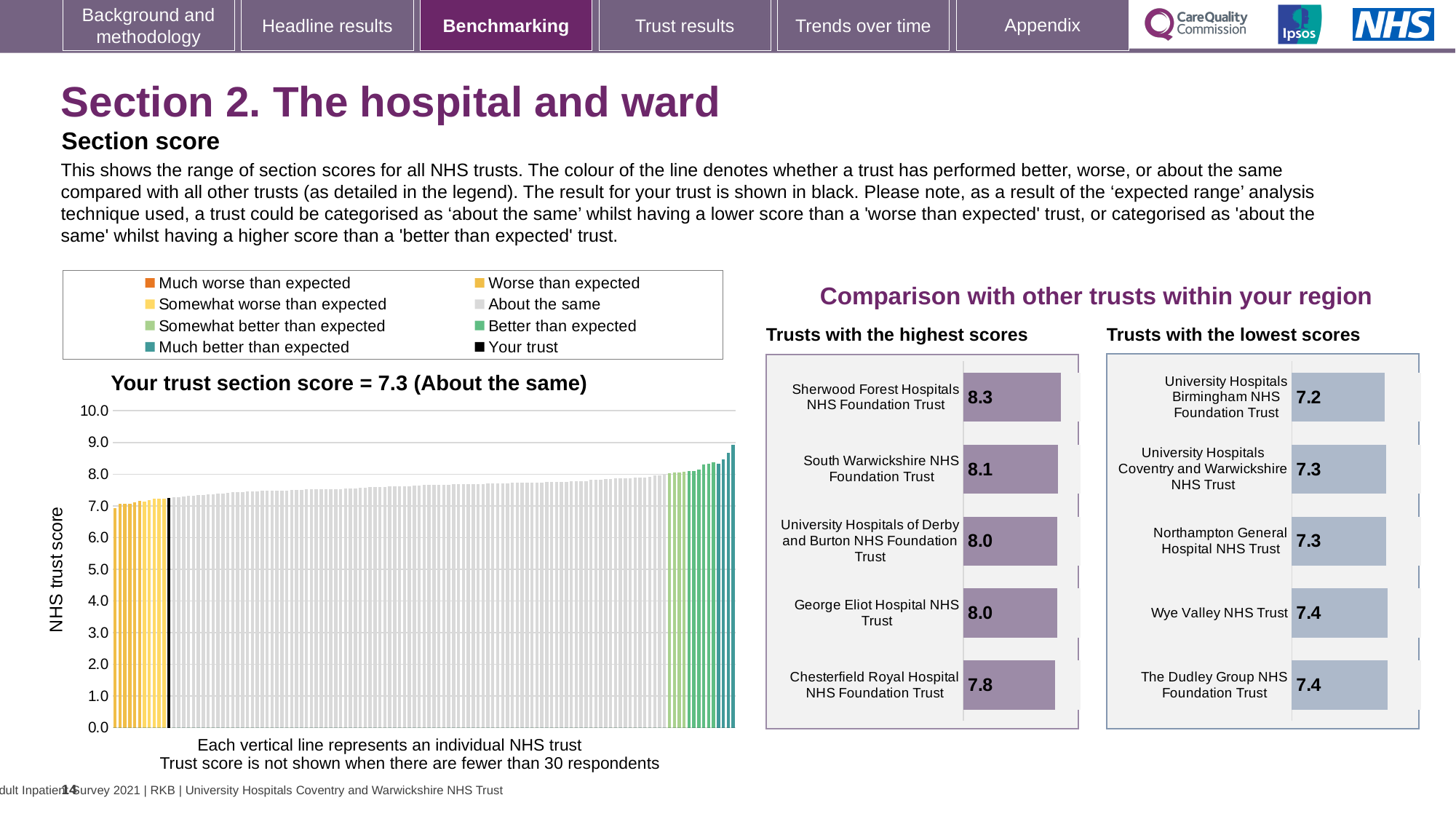
In the main chart on the left, do the trust scores rise or fall from left to right? rise In the 'Trusts with the highest scores' chart, what is the score for Chesterfield Royal Hospital NHS Foundation Trust? 7.8 In the 'Trusts with the lowest scores' chart, what is the score for Wye Valley NHS Trust? 7.4 In the main chart on the left, what is your trust's section score? 7.3 In the 'Trusts with the highest scores' chart, which trust has the highest score? Sherwood Forest Hospitals NHS Foundation Trust In the 'Trusts with the highest scores' chart, what is the difference between the scores of Sherwood Forest Hospitals NHS Foundation Trust and Chesterfield Royal Hospital NHS Foundation Trust? 0.5 How many trusts are shown in the 'Trusts with the lowest scores' chart? 5 How many entries does the legend above the main chart on the left list? 8 In the 'Trusts with the lowest scores' chart, what is the score for University Hospitals Birmingham NHS Foundation Trust? 7.2 In the 'Trusts with the highest scores' chart, which has the larger score: South Warwickshire NHS Foundation Trust or George Eliot Hospital NHS Trust? South Warwickshire NHS Foundation Trust In the 'Trusts with the lowest scores' chart, which trust has the lowest score? University Hospitals Birmingham NHS Foundation Trust In the 'Trusts with the highest scores' chart, what is the score for Sherwood Forest Hospitals NHS Foundation Trust? 8.3